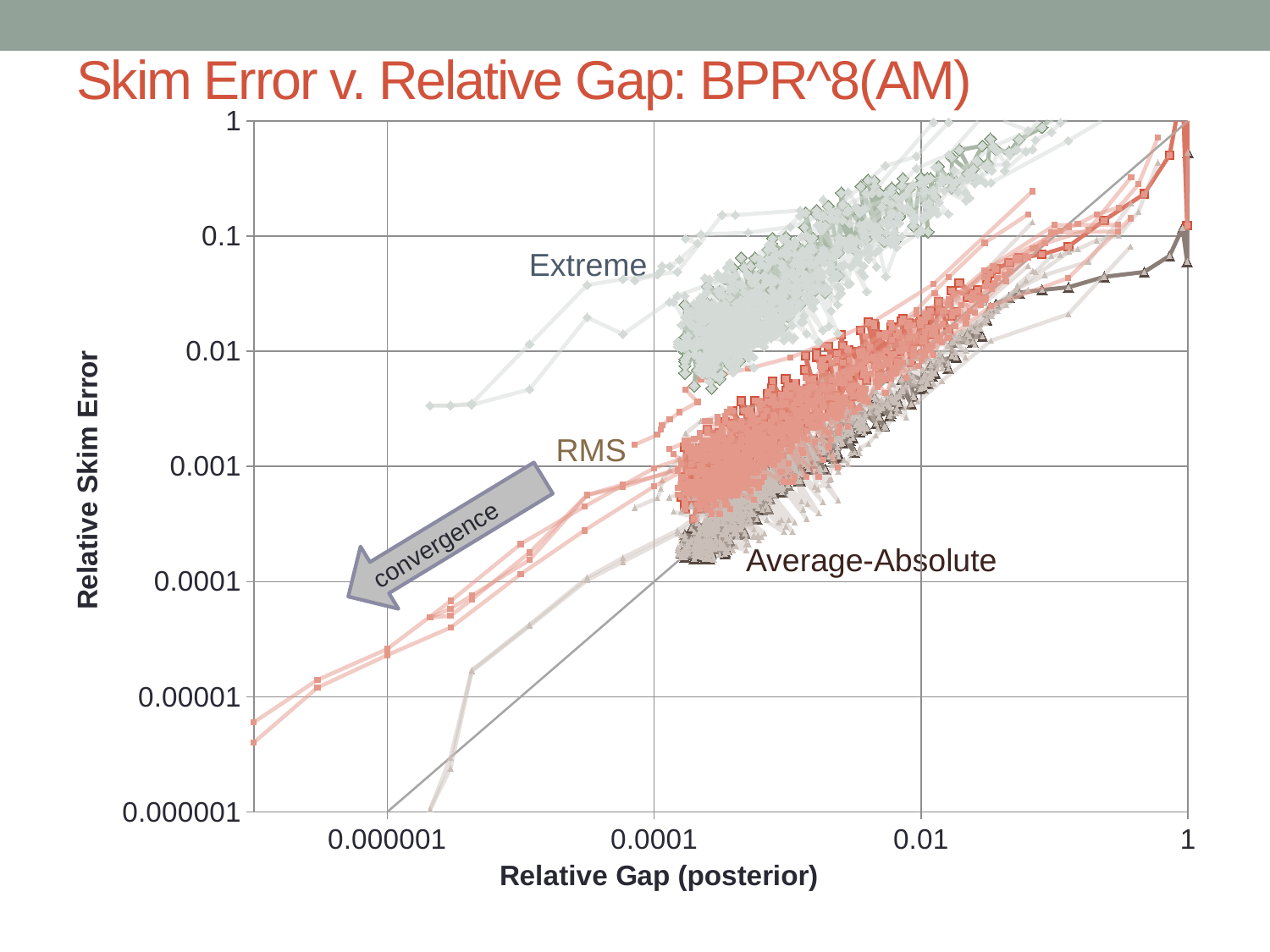
At a relative gap of 0.0001, is the relative skim error for the Average-Absolute series greater or less than 0.001? less Which series has the highest relative skim error at a given relative gap? Extreme Which series has the lowest relative skim error at a given relative gap? Average-Absolute What word is written on the arrow pointing toward the lower left of the chart? convergence How many labeled series are plotted on the chart? 3 What is the title of the chart? Skim Error v. Relative Gap: BPR^8(AM) At a relative gap of 0.01, is the relative skim error for the Extreme series greater or less than 0.01? greater What kind of chart is shown on the slide? scatter chart What is the highest value shown on the y axis? 1 At a relative gap of 0.01, which series has the larger relative skim error, Extreme or Average-Absolute? Extreme Does the relative skim error rise or fall as the relative gap increases along the x axis? rise What is the lowest value shown on the y axis? 0.000001